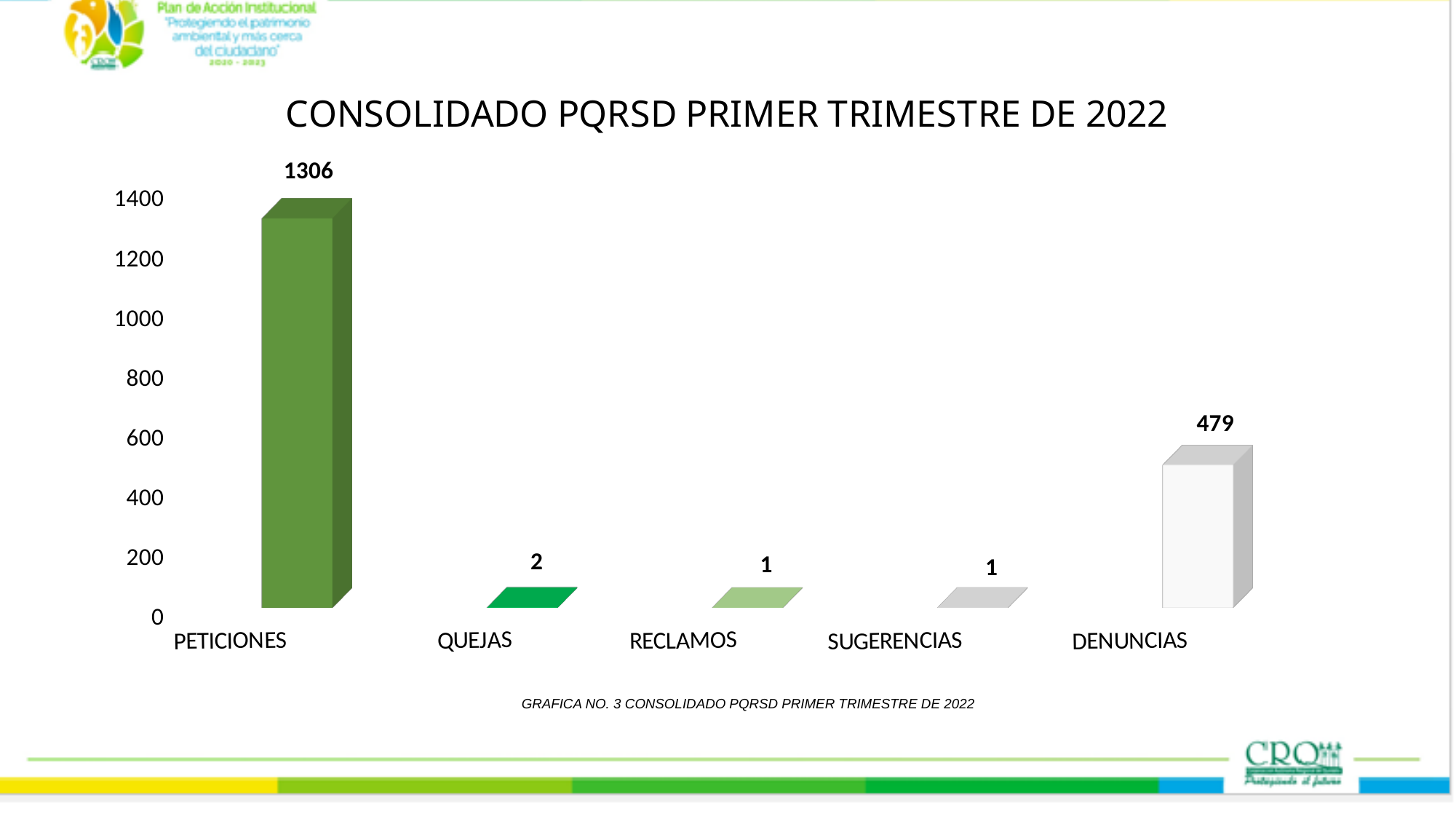
What is the value for DENUNCIAS? 479 How many categories are shown on the x axis? 5 What is the difference between the values for PETICIONES and DENUNCIAS? 827 Which is larger, the value for QUEJAS or the value for DENUNCIAS? DENUNCIAS What is the value for RECLAMOS? 1 What is the value for QUEJAS? 2 What is the difference between the values for QUEJAS and SUGERENCIAS? 1 Is the value for DENUNCIAS greater or less than 400? greater What kind of chart is shown on the slide? bar chart What is the title of the chart? CONSOLIDADO PQRSD PRIMER TRIMESTRE DE 2022 What is the value for PETICIONES? 1306 Which category has the highest value? PETICIONES